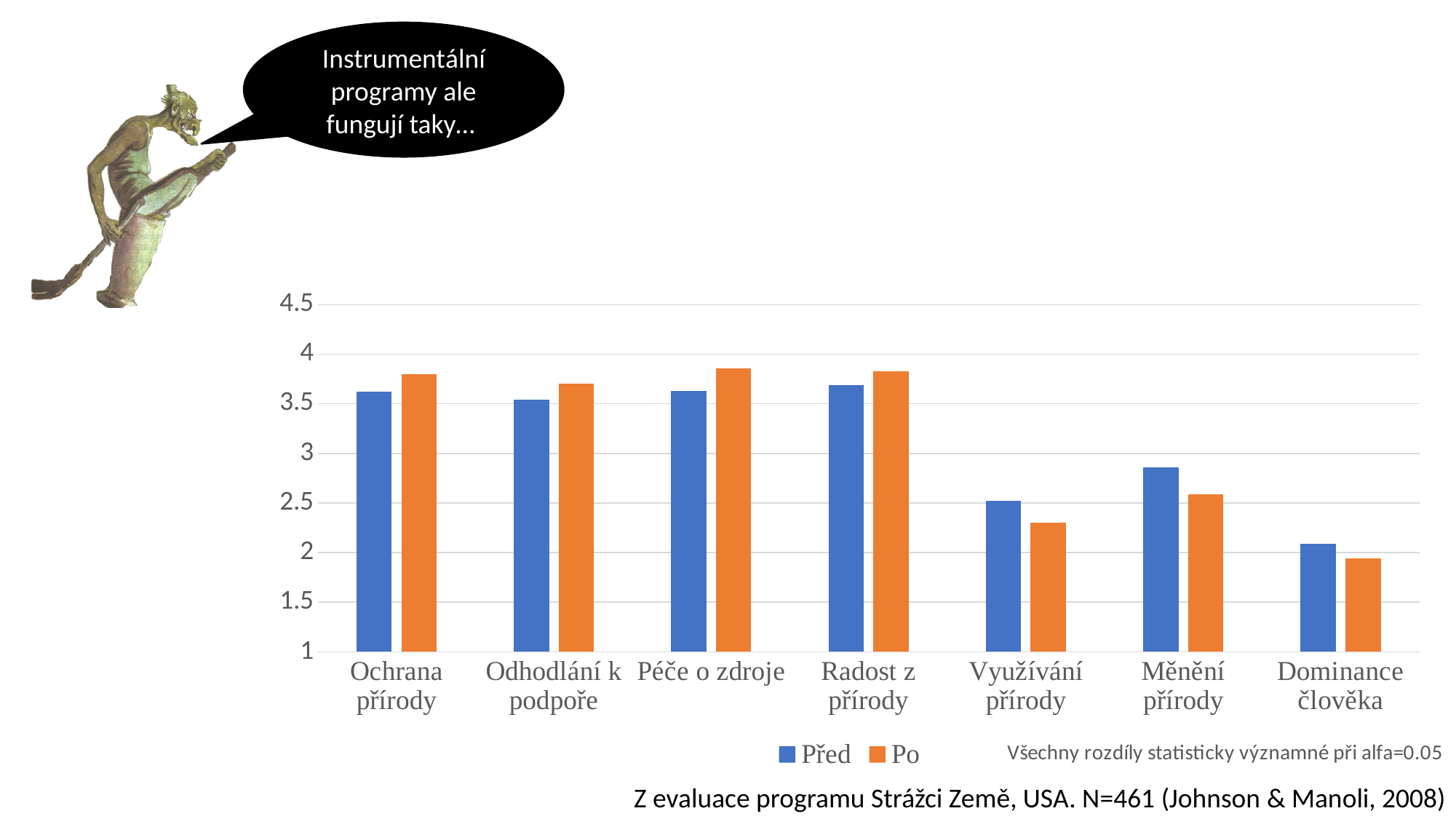
Is the Před value for Měnění přírody greater or less than 2.5? greater How many categories are shown on the x axis of the chart? 7 Which category has the lowest value for the Po series? Dominance člověka What are the two series named in the chart legend? Před and Po Is the Po value for Ochrana přírody greater or less than 3.5? greater How many series does the chart legend list? 2 What kind of chart is shown on the slide? bar chart For Ochrana přírody, which is larger: the Před value or the Po value? Po Which colour represents the Po series in the chart? orange For Využívání přírody, which is larger: the Před value or the Po value? Před Is the Po value for Dominance člověka greater or less than 2? less Which category has the lowest value for the Před series? Dominance člověka